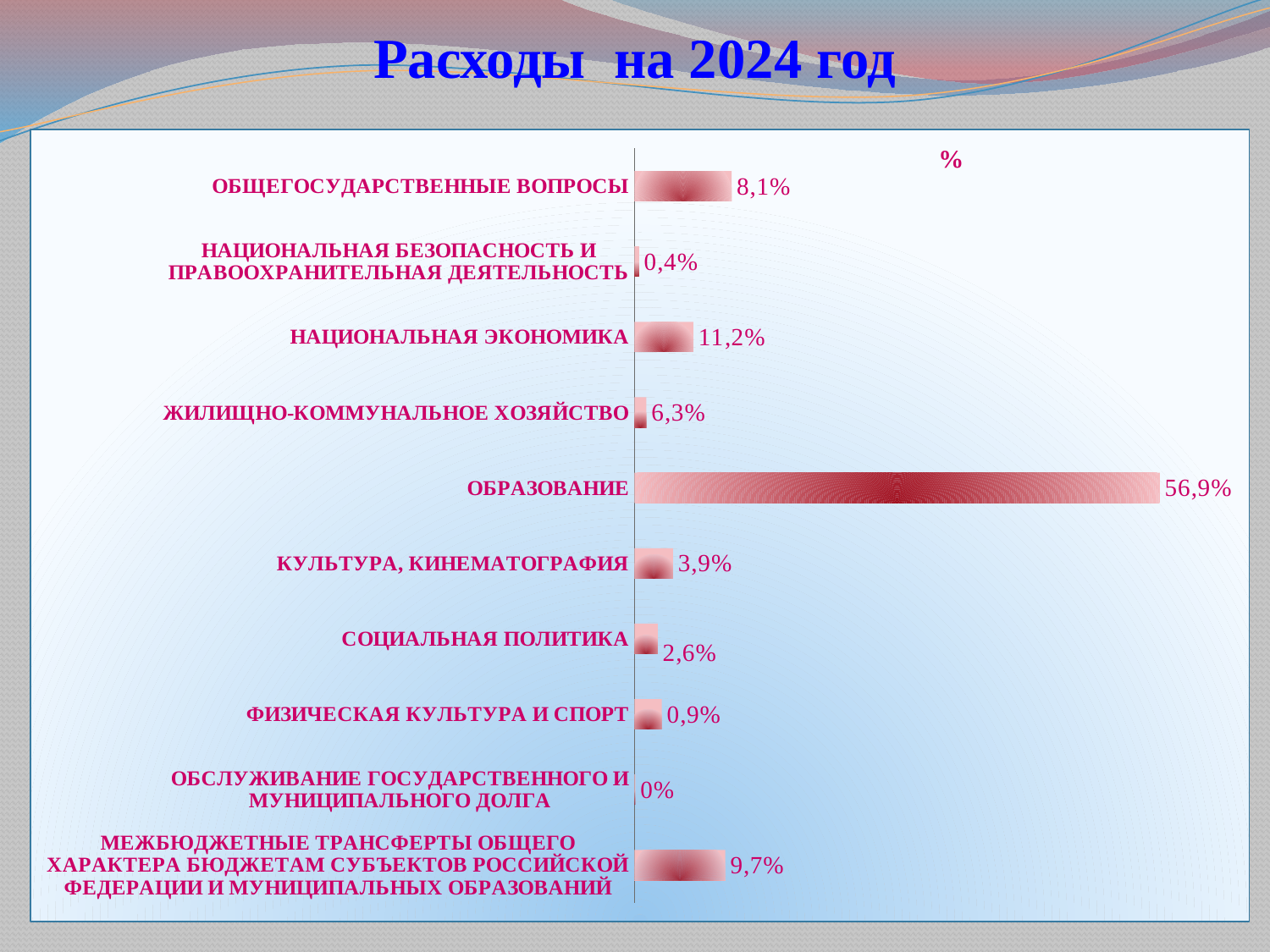
What is the value for ОБЩЕГОСУДАРСТВЕННЫЕ ВОПРОСЫ? 8,1% What is the difference between the values for НАЦИОНАЛЬНАЯ ЭКОНОМИКА and ОБЩЕГОСУДАРСТВЕННЫЕ ВОПРОСЫ? 3,1% What is the value for СОЦИАЛЬНАЯ ПОЛИТИКА? 2,6% What is the value for ОБРАЗОВАНИЕ? 56,9% What kind of chart is shown on the slide? Bar chart What is the value for НАЦИОНАЛЬНАЯ ЭКОНОМИКА? 11,2% What is the difference between the values for ОБРАЗОВАНИЕ and НАЦИОНАЛЬНАЯ ЭКОНОМИКА? 45,7% What is the value for ОБСЛУЖИВАНИЕ ГОСУДАРСТВЕННОГО И МУНИЦИПАЛЬНОГО ДОЛГА? 0% Which category has the highest value? ОБРАЗОВАНИЕ How many categories are shown in the chart? 10 Which category has the lowest value? ОБСЛУЖИВАНИЕ ГОСУДАРСТВЕННОГО И МУНИЦИПАЛЬНОГО ДОЛГА